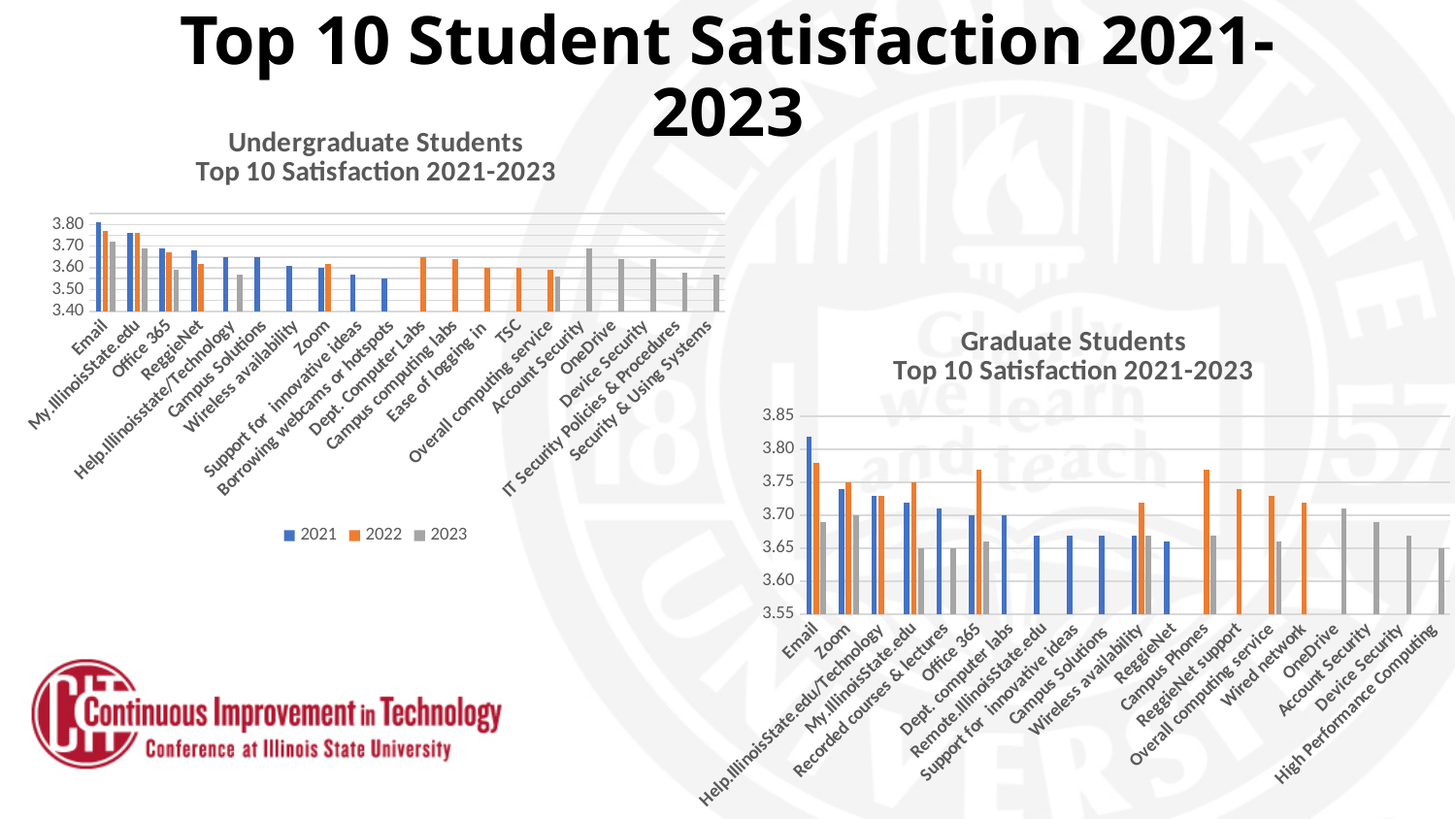
How many series does the legend of the Undergraduate Students Top 10 Satisfaction 2021-2023 chart list? 3 In the Graduate Students Top 10 Satisfaction 2021-2023 chart, is the 2022 value for Campus Phones greater or less than 3.75? greater What type of chart is the Undergraduate Students Top 10 Satisfaction 2021-2023 chart? bar chart In the Undergraduate Students Top 10 Satisfaction 2021-2023 chart, which category has the highest 2021 value? Email In the Graduate Students Top 10 Satisfaction 2021-2023 chart, which category has the highest 2021 value? Email In the Undergraduate Students Top 10 Satisfaction 2021-2023 chart, do the 2021 values generally rise or fall moving left to right along the x axis? fall How many categories are shown on the x axis of the Graduate Students Top 10 Satisfaction 2021-2023 chart? 20 In the Undergraduate Students Top 10 Satisfaction 2021-2023 chart, is the 2021 value for Email greater or less than 3.70? greater In the Undergraduate Students Top 10 Satisfaction 2021-2023 chart, is the 2021 value for Borrowing webcams or hotspots greater or less than 3.60? less In the Undergraduate Students Top 10 Satisfaction 2021-2023 chart, which years are listed in the legend? 2021, 2022, 2023 How many categories are shown on the x axis of the Undergraduate Students Top 10 Satisfaction 2021-2023 chart? 20